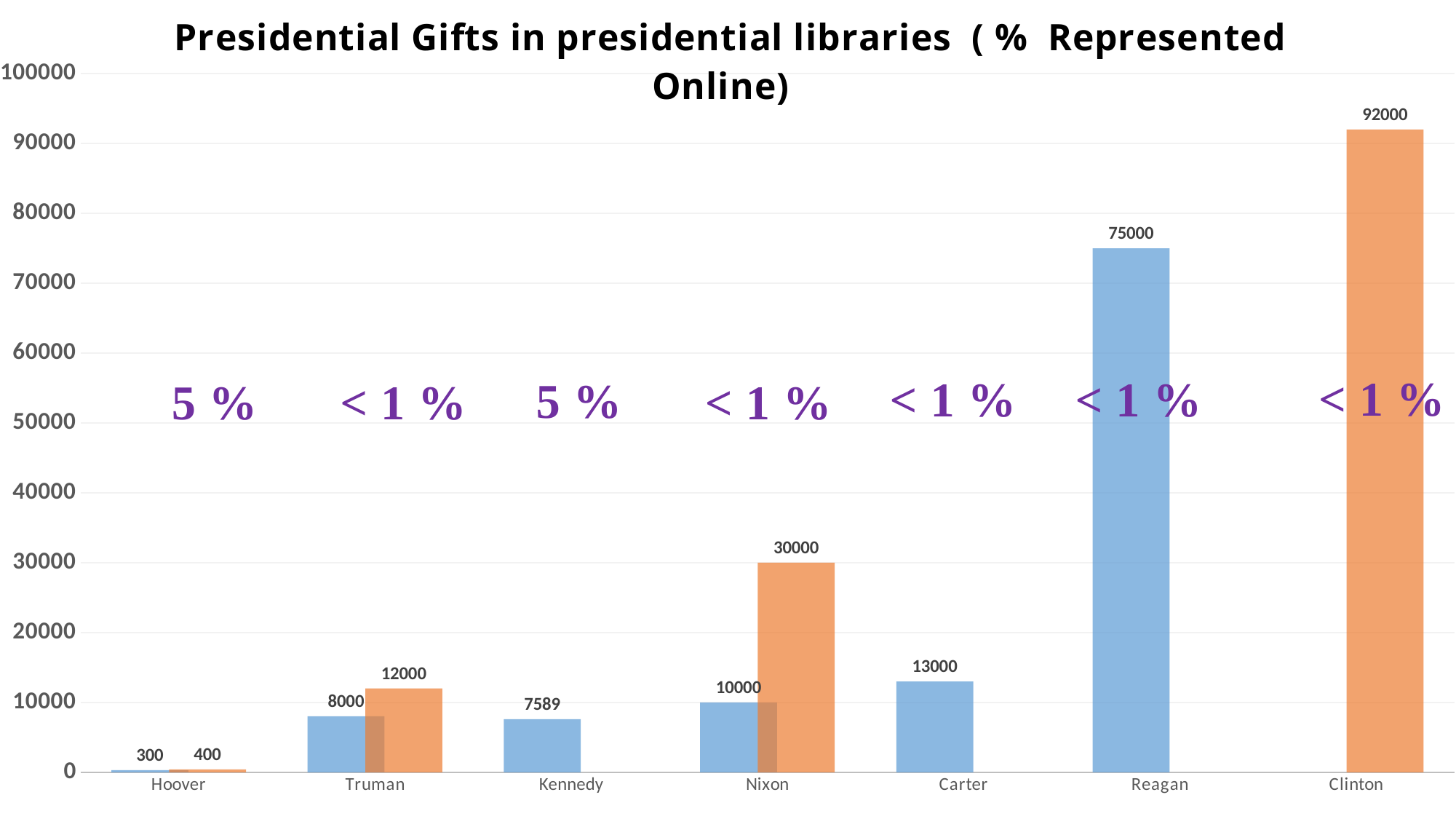
Which is larger, the blue bar for Carter or the blue bar for Nixon? Carter What kind of chart is shown on the slide? Bar chart What percentage is shown above the Kennedy bar as represented online? 5 % What is the value of the orange bar for Nixon? 30000 What is the difference between the orange bar and the blue bar for Truman? 4000 What is the difference between the Clinton orange bar and the Reagan blue bar? 17000 What is the value of the blue bar for Kennedy? 7589 What is the value of the orange bar for Clinton? 92000 Which president has the lowest blue bar value? Hoover Which president has the tallest bar on the chart? Clinton What is the value of the blue bar for Reagan? 75000 How many presidents are shown on the x axis? 7